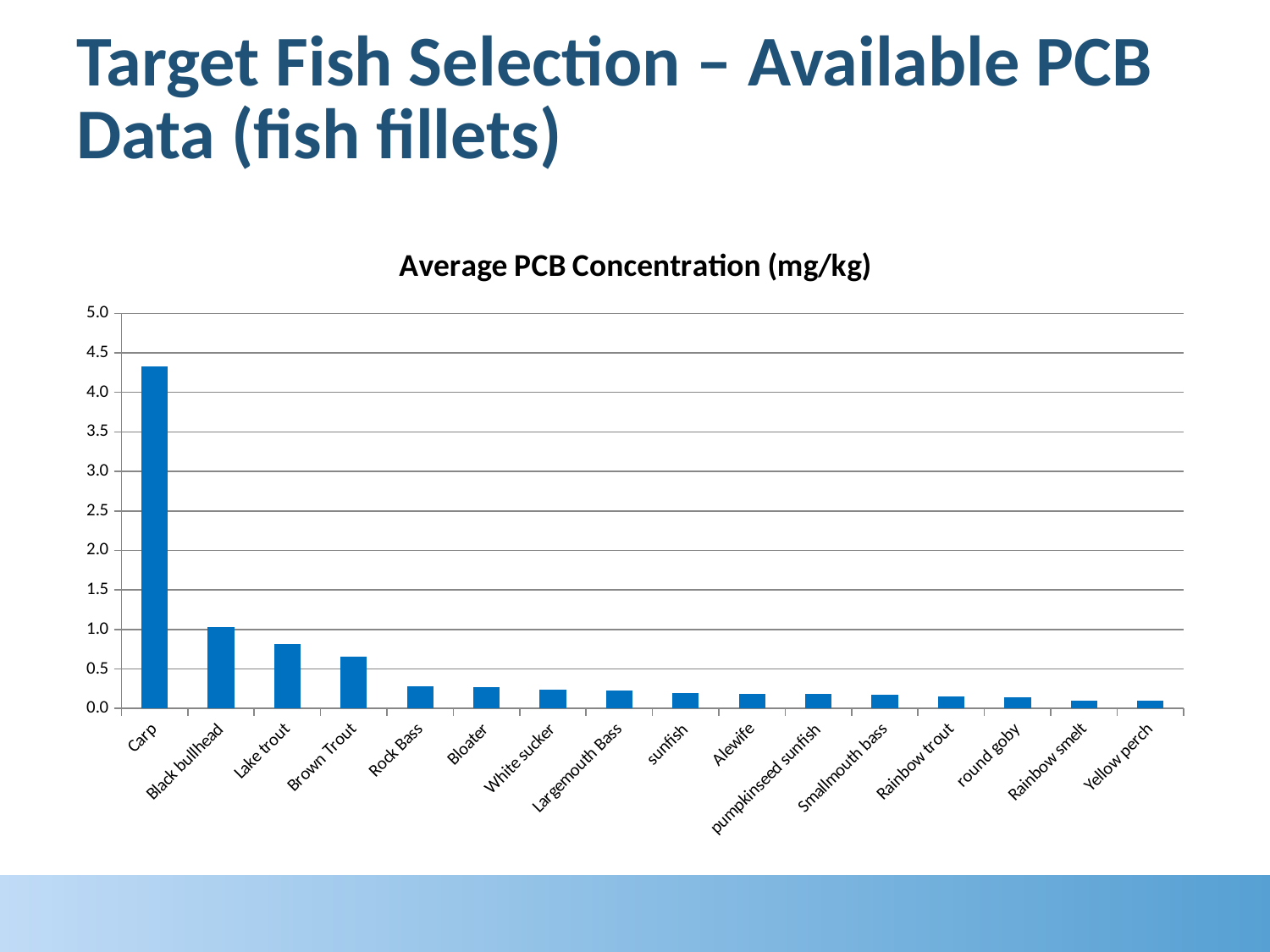
Which fish has the highest average PCB concentration? Carp Do the values generally rise or fall moving from left to right along the x axis? fall Is the value for Carp greater or less than 4.0? greater Is the value for Carp greater or less than 4.5? less Which has a higher average PCB concentration, Carp or Black bullhead? Carp Is the value for Lake trout greater or less than 0.5? greater How many fish species are shown on the x axis of the chart? 16 Which has a higher average PCB concentration, Lake trout or Brown Trout? Lake trout What is the title of the chart? Average PCB Concentration (mg/kg) What kind of chart is shown on the slide? bar chart